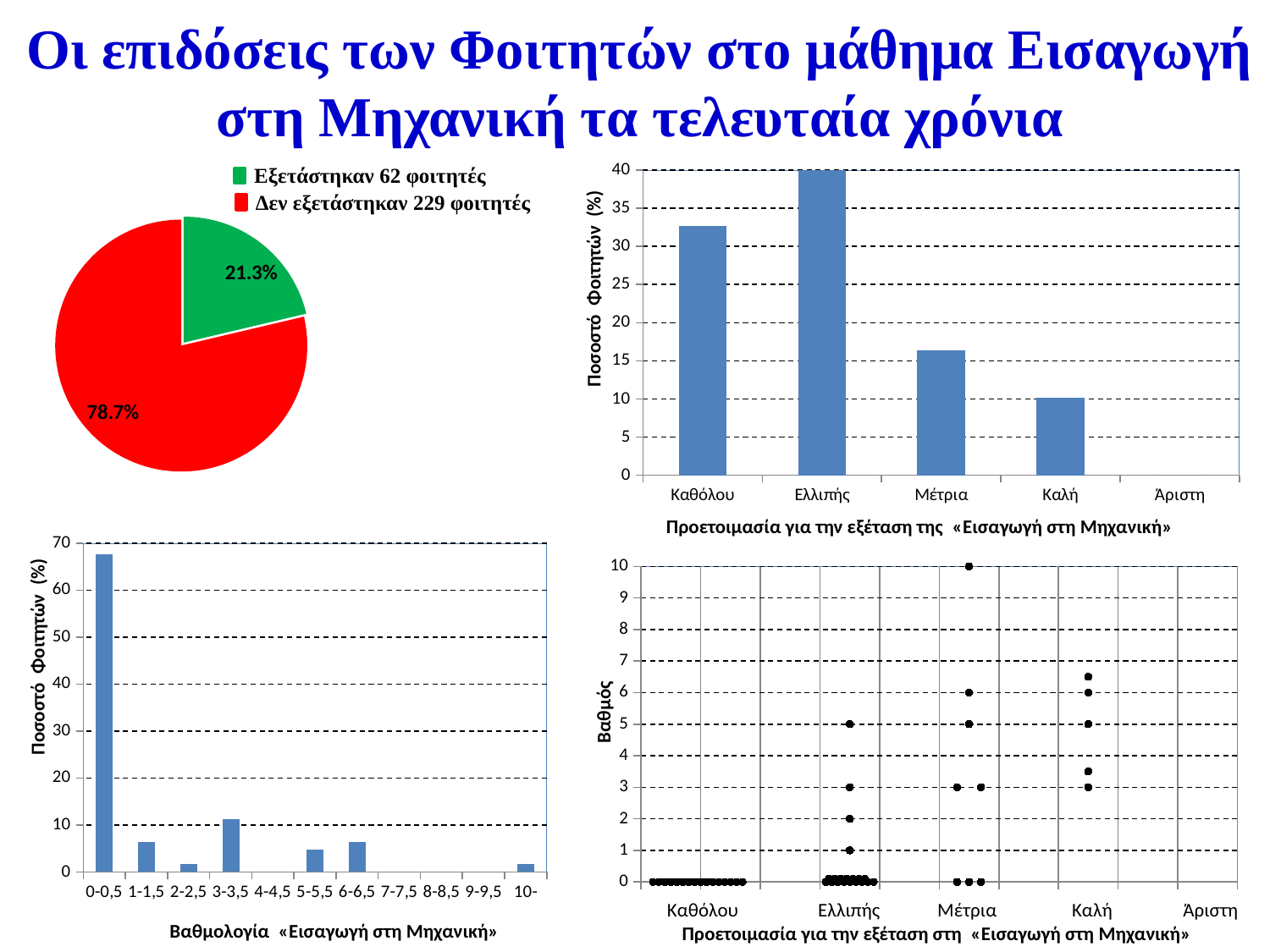
On the bottom-left chart (Βαθμολογία), is the value for 0-0,5 greater or less than 60? greater On the pie chart at the top left, how many slices does the pie have? 2 What kind of chart is the top-right chart (Προετοιμασία για την εξέταση)? bar chart On the bottom-right chart (Βαθμός vs Προετοιμασία), which preparation category contains the point with the highest grade? Μέτρια On the pie chart at the top left, which slice is larger, Εξετάστηκαν or Δεν εξετάστηκαν? Δεν εξετάστηκαν On the top-right chart (Προετοιμασία για την εξέταση), which category has the highest percentage of students? Ελλιπής On the pie chart at the top left, what percentage is shown for the green slice (Εξετάστηκαν 62 φοιτητές)? 21.3% On the pie chart at the top left, what percentage is shown for the red slice (Δεν εξετάστηκαν 229 φοιτητές)? 78.7% On the top-right chart (Προετοιμασία για την εξέταση), is the value for Μέτρια greater or less than 20? less On the top-right chart (Προετοιμασία για την εξέταση), is the value for Καθόλου greater or less than 30? greater On the top-right chart (Προετοιμασία για την εξέταση), how many categories are shown on the x axis? 5 On the bottom-left chart (Βαθμολογία), which grade range has the highest percentage of students? 0-0,5